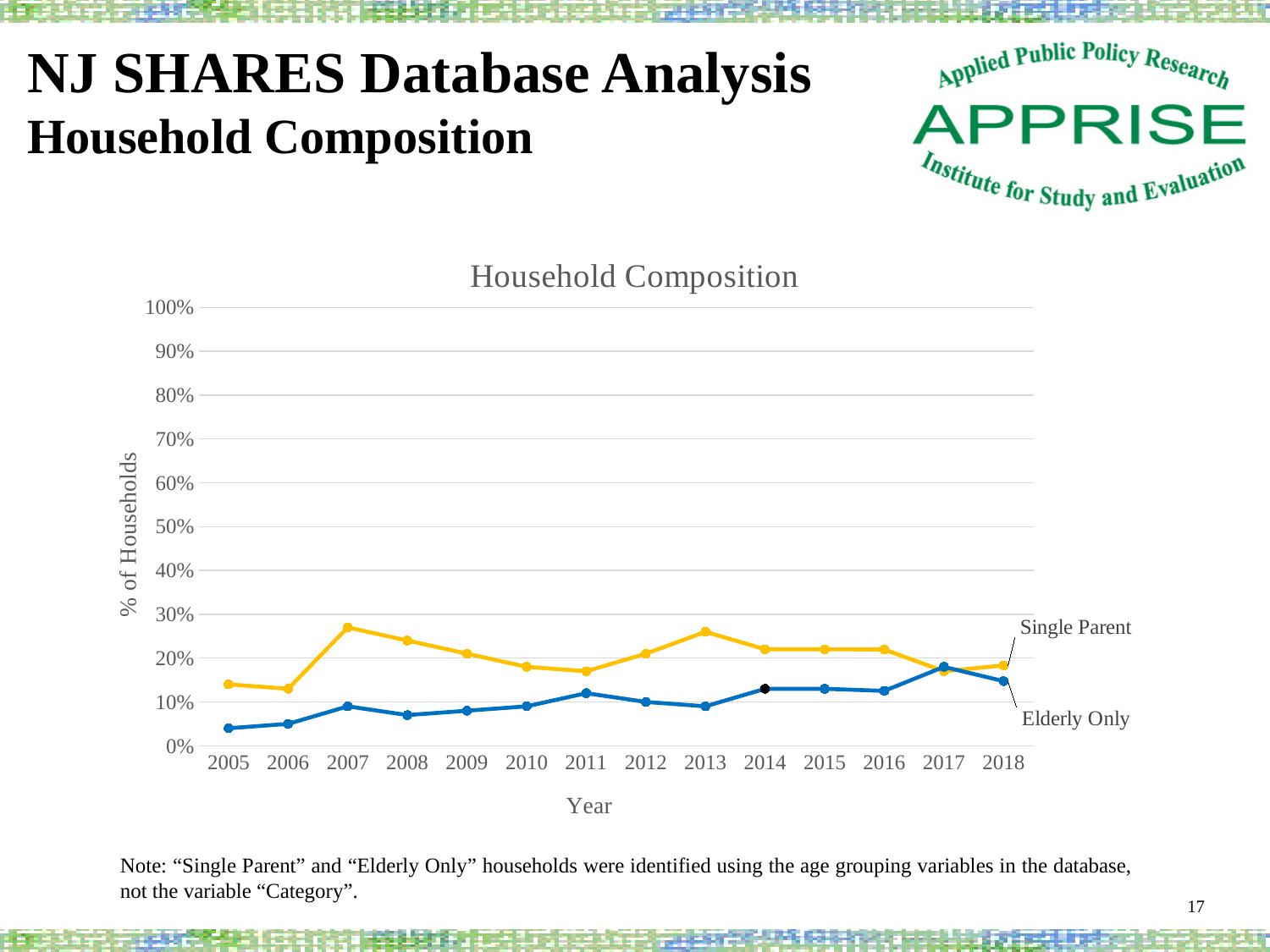
In 2005, which series has the higher value, Single Parent or Elderly Only? Single Parent How many series are plotted in the Household Composition chart? 2 What is the label on the y axis of the chart? % of Households Does the Single Parent series rise or fall from 2007 to 2011? Fall How many years are shown on the x axis of the chart? 14 Is the value for Elderly Only in 2011 greater or less than 10%? greater What kind of chart is shown on the slide? Line chart In which year is the Single Parent series at its lowest? 2006 Is the value for Single Parent in 2011 greater or less than 20%? less In which year is the Elderly Only series at its highest? 2017 Is the value for Single Parent in 2007 greater or less than 20%? greater